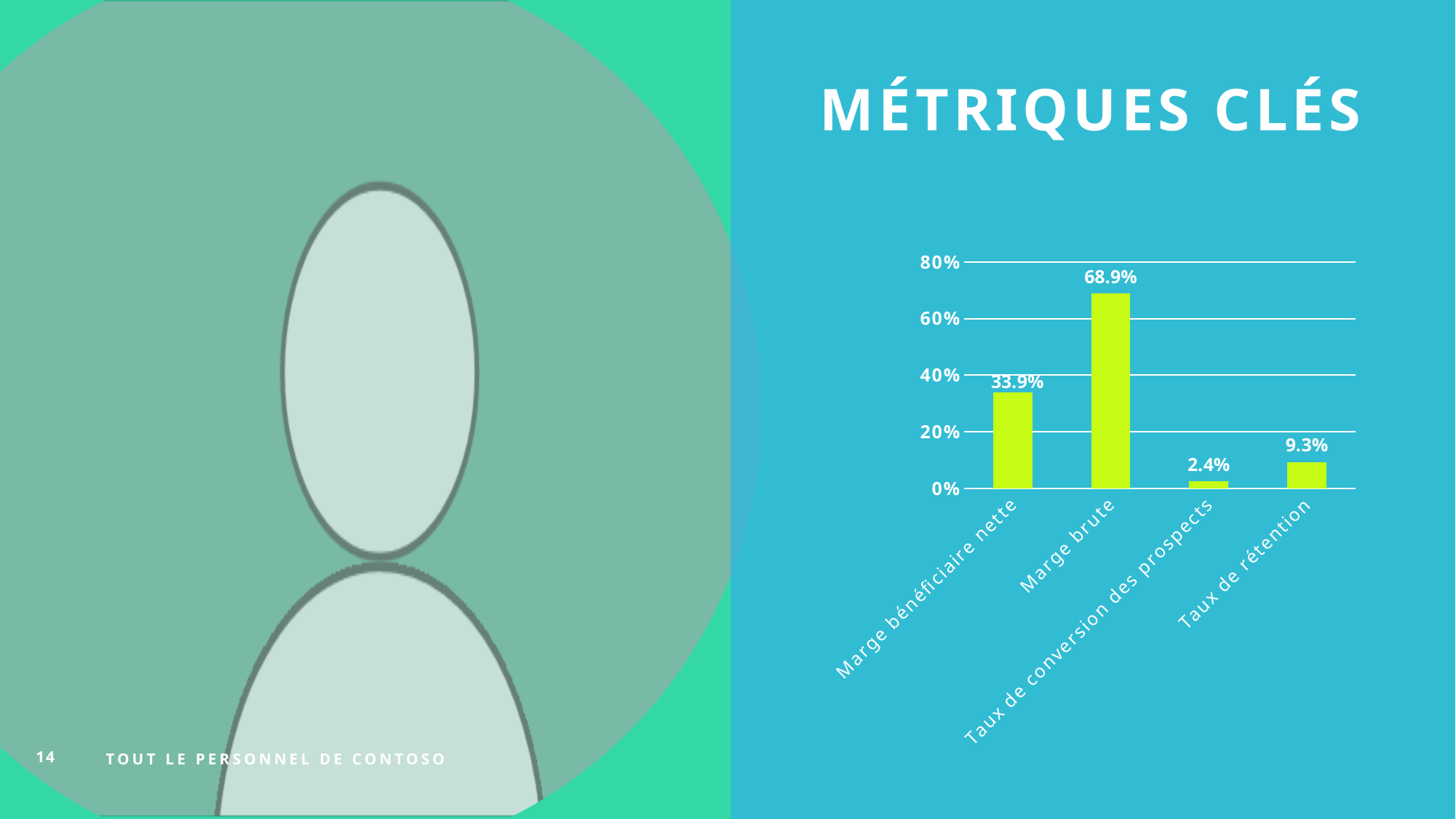
What is the value for Taux de conversion des prospects? 2.4% Which category has the highest value? Marge brute Which category has the lowest value? Taux de conversion des prospects What kind of chart is shown on the slide? bar chart What is the difference between Marge brute and Marge bénéficiaire nette? 35.0% What is the value for Marge brute? 68.9% How many categories are shown in the chart? 4 What is the value for Marge bénéficiaire nette? 33.9% What is the value for Taux de rétention? 9.3% What is the title of the slide containing the chart? MÉTRIQUES CLÉS Is the value for Marge bénéficiaire nette greater or less than 40%? less Which is larger, Taux de rétention or Taux de conversion des prospects? Taux de rétention